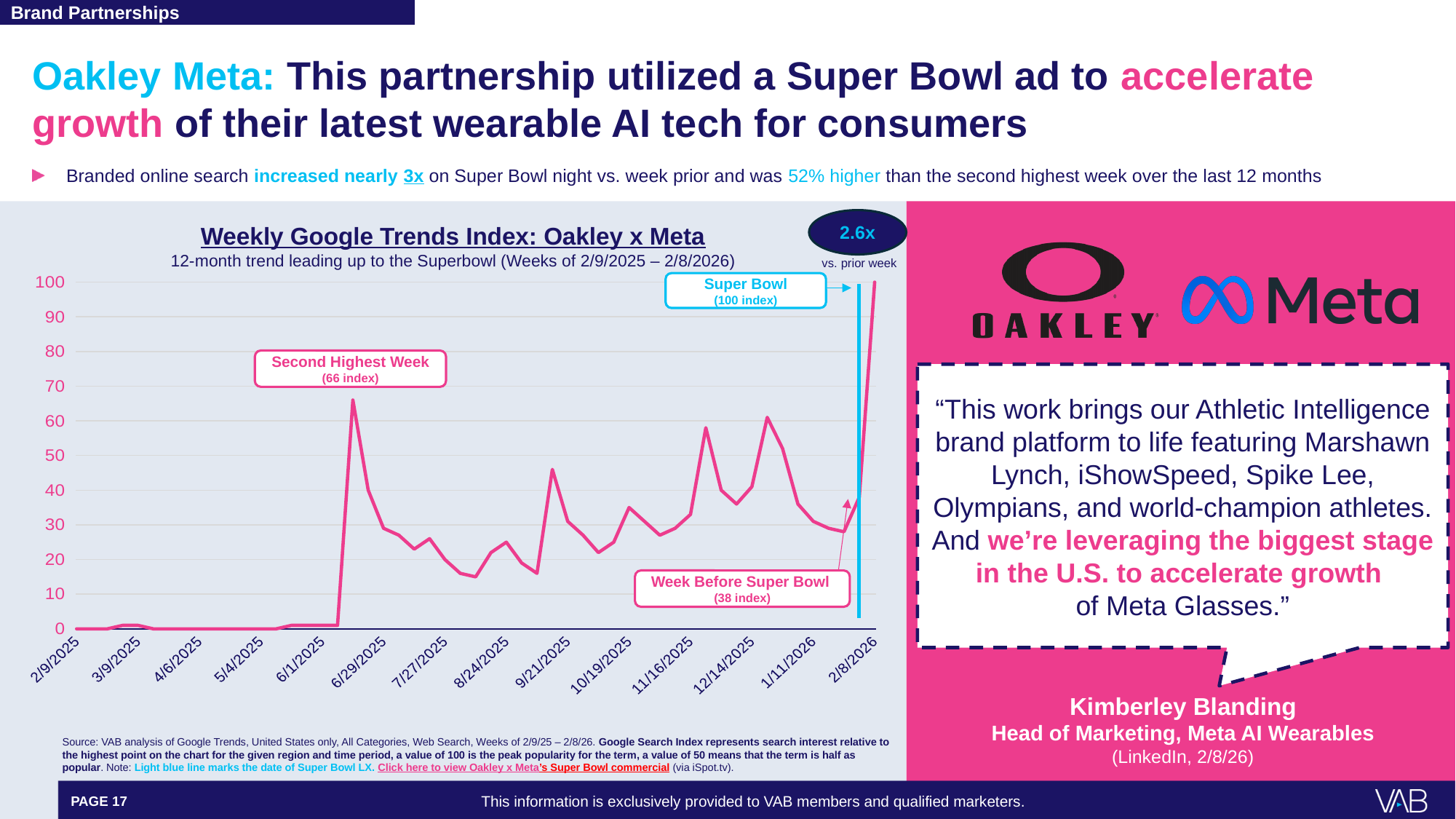
What is the title of the chart? Weekly Google Trends Index: Oakley x Meta Which week has the highest index value on the chart? 2/8/2026 (Super Bowl week) What is the Google Trends index value for the Super Bowl week? 100 Is the index value for the week of 2/9/2025 greater or less than 10? less Does the line rise or fall from the week before the Super Bowl to the Super Bowl week? rise What is the difference between the Super Bowl week index and the week before Super Bowl index? 62 What is the index value for the second highest week? 66 What is the index value for the week before the Super Bowl? 38 Which is larger: the index for the second highest week or the index for the week before the Super Bowl? second highest week How many date labels are shown on the x axis? 14 What is the difference between the Super Bowl week index and the second highest week index? 34 What kind of chart is shown on the slide? line chart